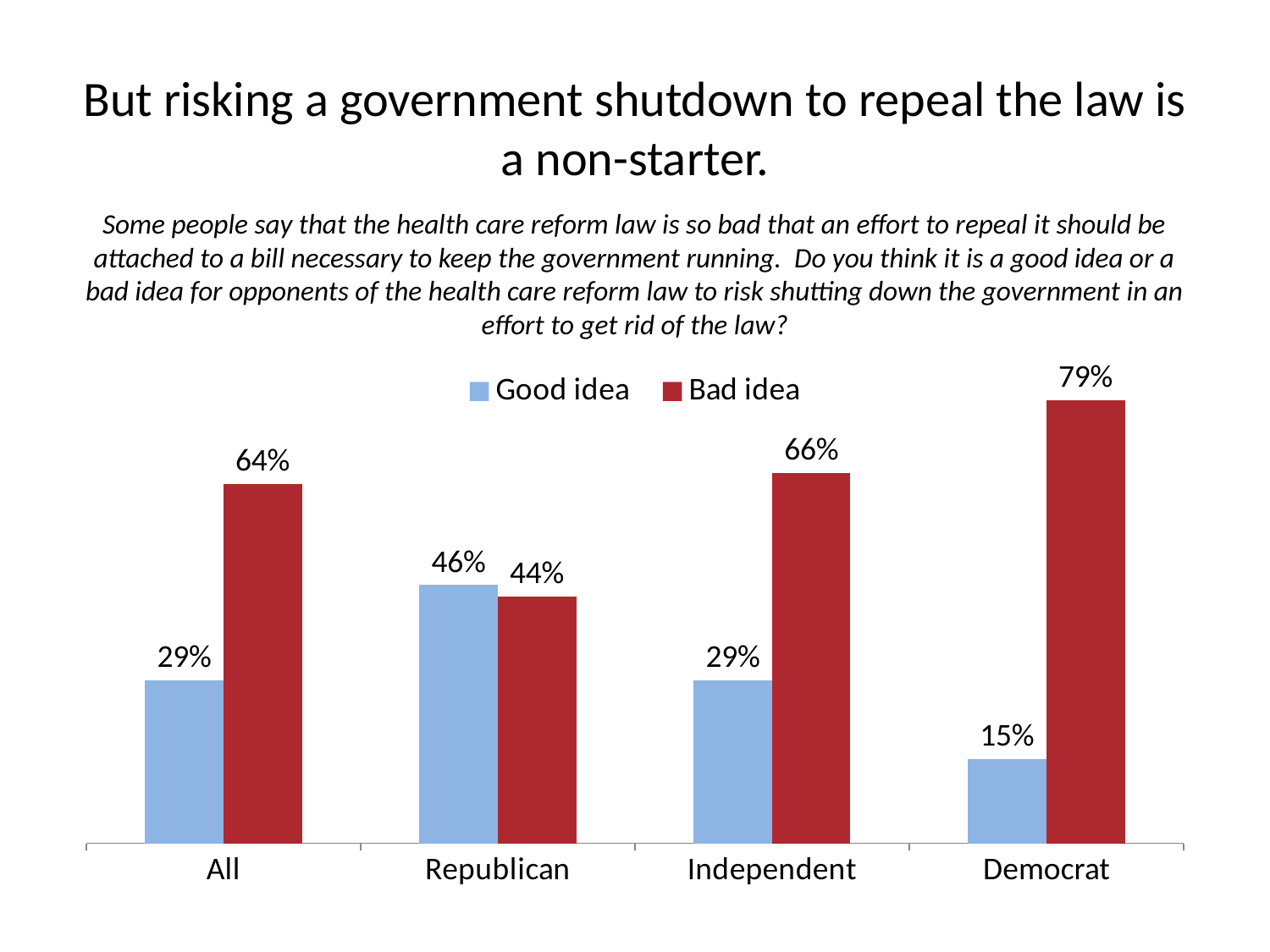
What is the difference between the 'Bad idea' and 'Good idea' values for Democrats? 64 percentage points What is the 'Good idea' value for Independents? 29% What kind of chart is shown on the slide? Bar chart How many series does the legend list? 2 For Republicans, which is larger: the 'Good idea' value or the 'Bad idea' value? Good idea What is the 'Bad idea' value for the All category? 64% What percentage of Republicans say risking a government shutdown is a good idea? 46% Which colour represents the 'Bad idea' series? Red What percentage of Democrats say risking a government shutdown is a bad idea? 79% Which category has the lowest 'Good idea' value? Democrat Which category has the highest 'Bad idea' value? Democrat How many categories are shown on the x axis? 4